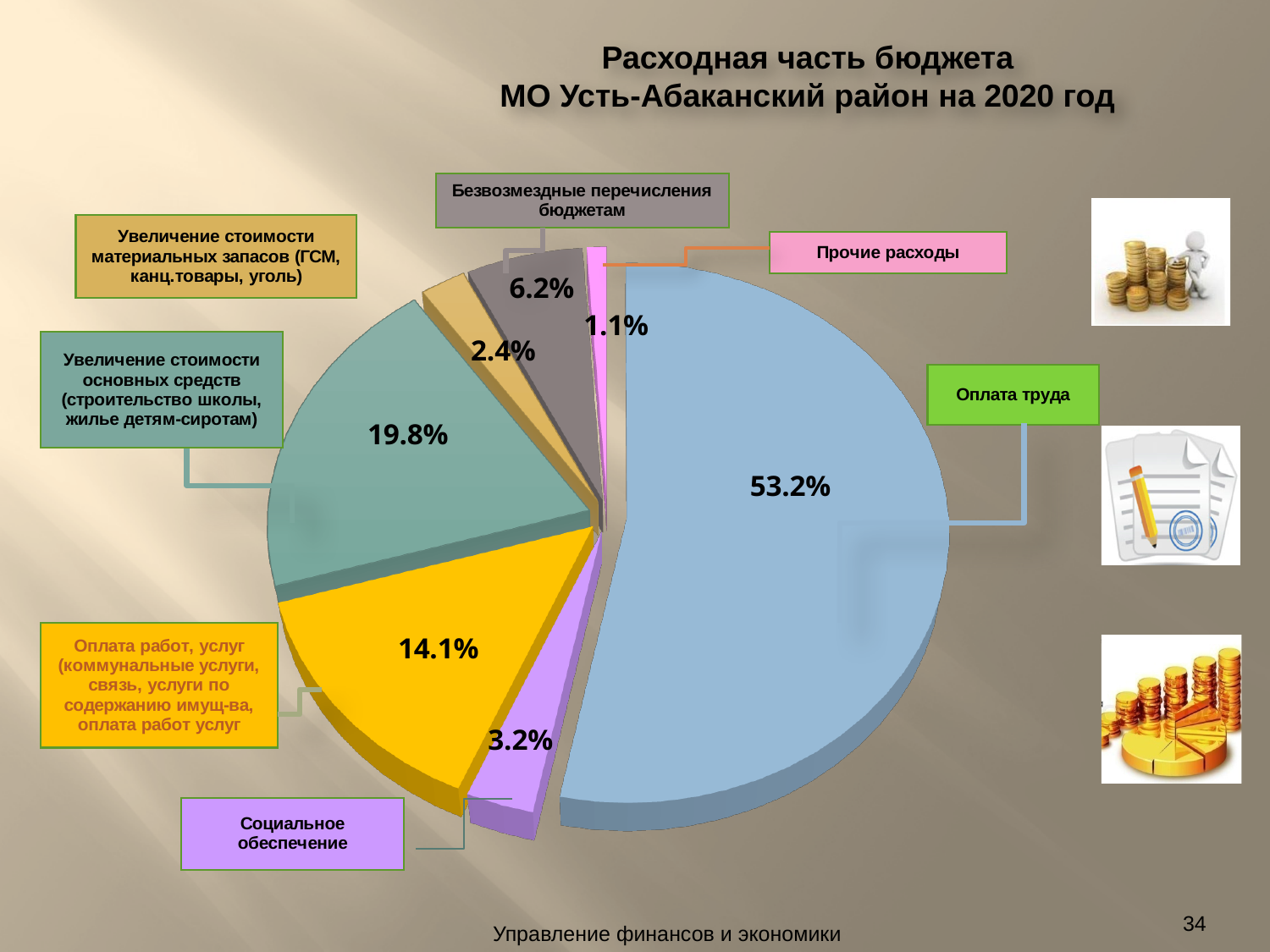
What share of the budget expenditure is labelled for Оплата труда? 53.2% What percentage is shown for Социальное обеспечение? 3.2% What percentage is shown for Безвозмездные перечисления бюджетам? 6.2% What is the difference in percentage points between Оплата труда and Оплата работ, услуг? 39.1 What is the title of the chart on the slide? Расходная часть бюджета МО Усть-Абаканский район на 2020 год What percentage is shown for Увеличение стоимости основных средств (строительство школы, жилье детям-сиротам)? 19.8% What percentage is shown for Прочие расходы? 1.1% What kind of chart is shown on the slide? pie chart Which category has the smallest share of the pie? Прочие расходы Which is larger: the share for Безвозмездные перечисления бюджетам or the share for Увеличение стоимости материальных запасов? Безвозмездные перечисления бюджетам How many slices does the pie chart have? 7 Which category has the largest share of the pie? Оплата труда